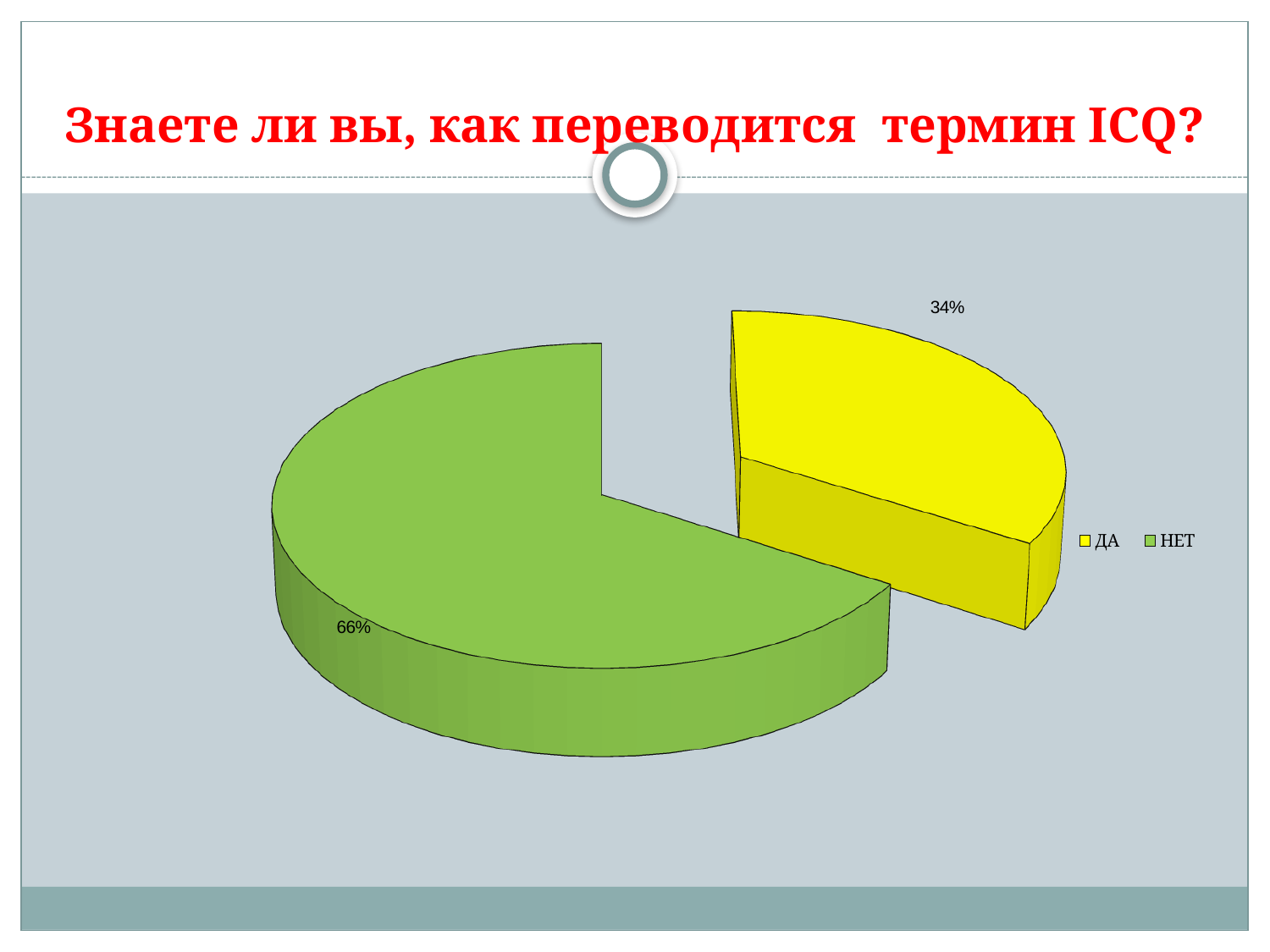
What kind of chart is shown on the slide? pie chart What is the total of the two slice percentages shown? 100% What is the difference in percentage points between the НЕТ and ДА slices? 32 What share of the pie does the ДА slice represent? 34% How many slices does the pie chart have? 2 What colour is the ДА slice? yellow What colour is the НЕТ slice? green What share of the pie does the НЕТ slice represent? 66% Which category has the largest slice of the pie? НЕТ Which slice is larger, ДА or НЕТ? НЕТ Which category has the smallest slice of the pie? ДА How many entries does the legend list? 2